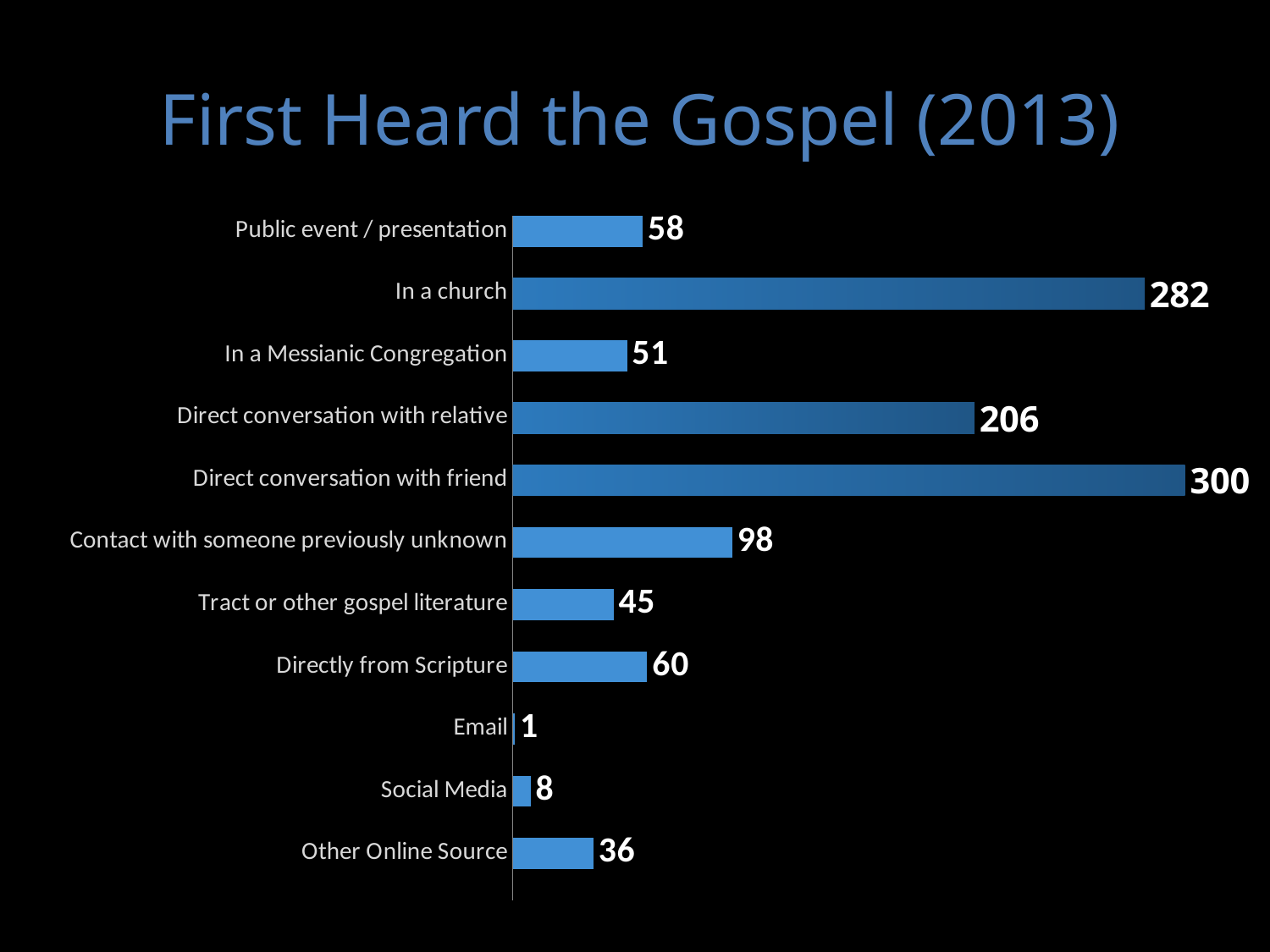
Which category has the highest value? Direct conversation with friend Which is larger, 'Public event / presentation' or 'In a Messianic Congregation'? Public event / presentation What is the value for 'In a church'? 282 What kind of chart is shown on the slide? Bar chart What is the value for 'Direct conversation with relative'? 206 What is the difference between 'Directly from Scripture' and 'Tract or other gospel literature'? 15 What is the value for 'Contact with someone previously unknown'? 98 What is the value for 'Social Media'? 8 What is the title of the chart? First Heard the Gospel (2013) How many categories are shown in the chart? 11 Which category has the lowest value? Email What is the difference between 'Direct conversation with friend' and 'In a church'? 18